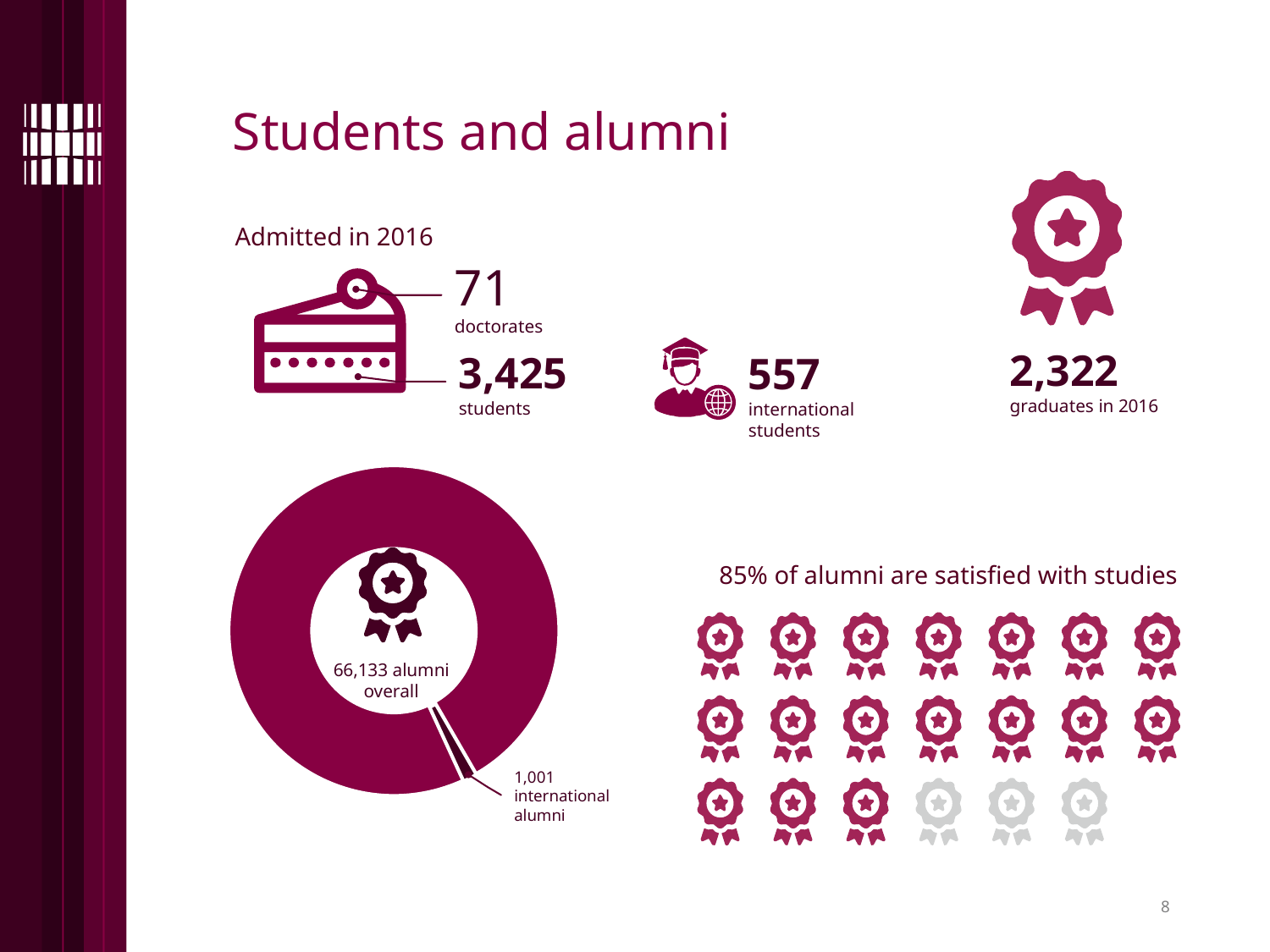
In the donut chart, how many international alumni are shown? 1,001 How many badge icons in the pictograph are coloured (highlighted)? 17 What kind of chart is shown in the lower left of the slide? Donut (pie) chart What is the title of the slide? Students and alumni How many badge icons in the pictograph are greyed out? 3 How many international students are shown on the slide? 557 How many badge icons in total are shown in the pictograph on the right? 20 According to the pictograph on the right, what percentage of alumni are satisfied with studies? 85% In the donut chart, which is larger: the number of alumni overall or the number of international alumni? Alumni overall How many doctorates were admitted in 2016 according to the slide? 71 In the donut chart, how many alumni are there overall? 66,133